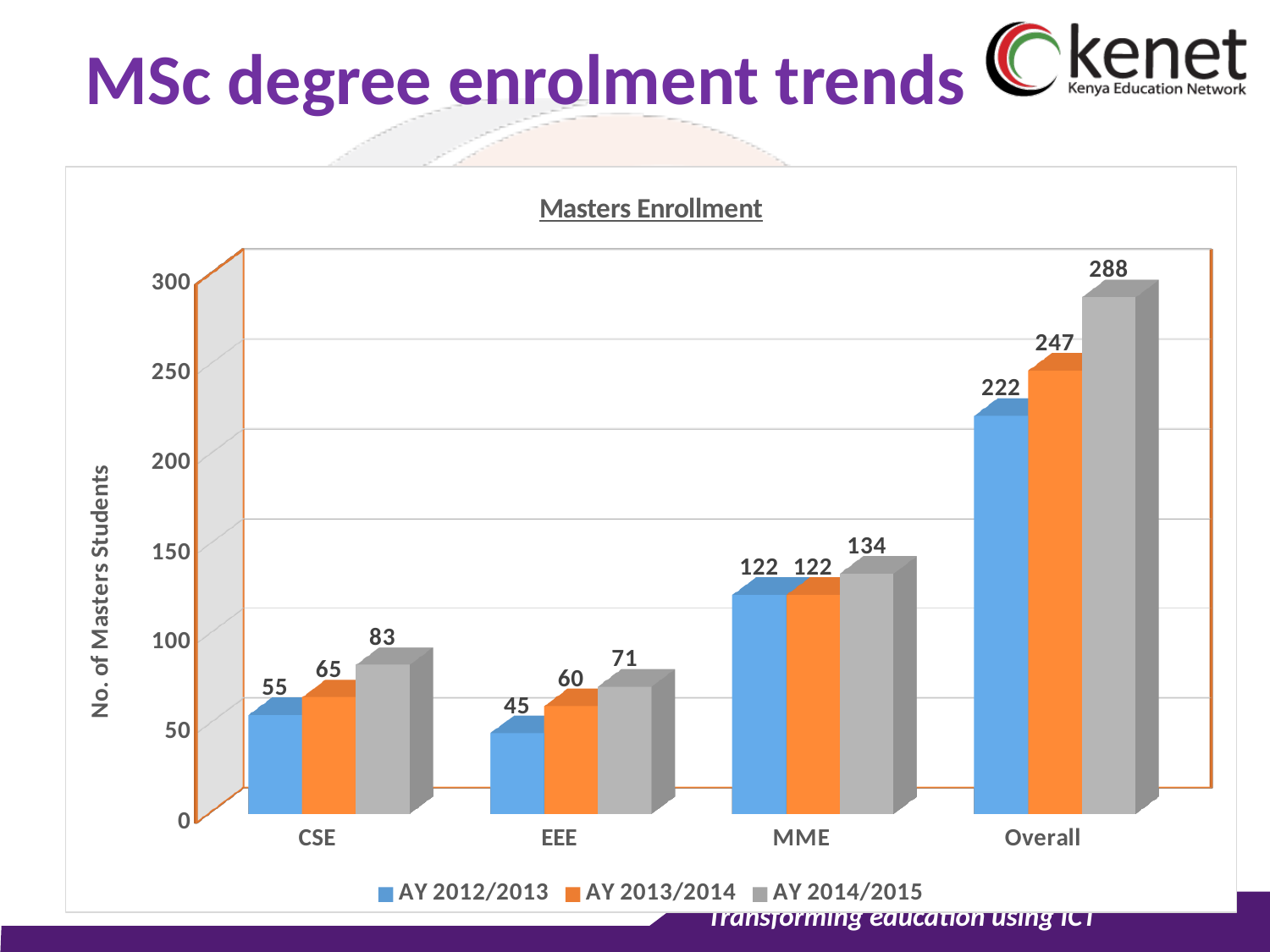
What is the value for MME in AY 2014/2015? 134 Which category has the highest value in AY 2014/2015? Overall What is the value for CSE in AY 2012/2013? 55 What is the difference between the Overall values for AY 2014/2015 and AY 2012/2013? 66 Which category has the lowest value in AY 2012/2013? EEE What kind of chart is shown? Bar chart Which is larger: CSE in AY 2014/2015 or EEE in AY 2014/2015? CSE in AY 2014/2015 Do the values for EEE rise or fall from AY 2012/2013 to AY 2014/2015? Rise How many categories are shown on the x axis? 4 What is the Overall value for AY 2013/2014? 247 How many series does the legend list? 3 What is the title of the chart? Masters Enrollment